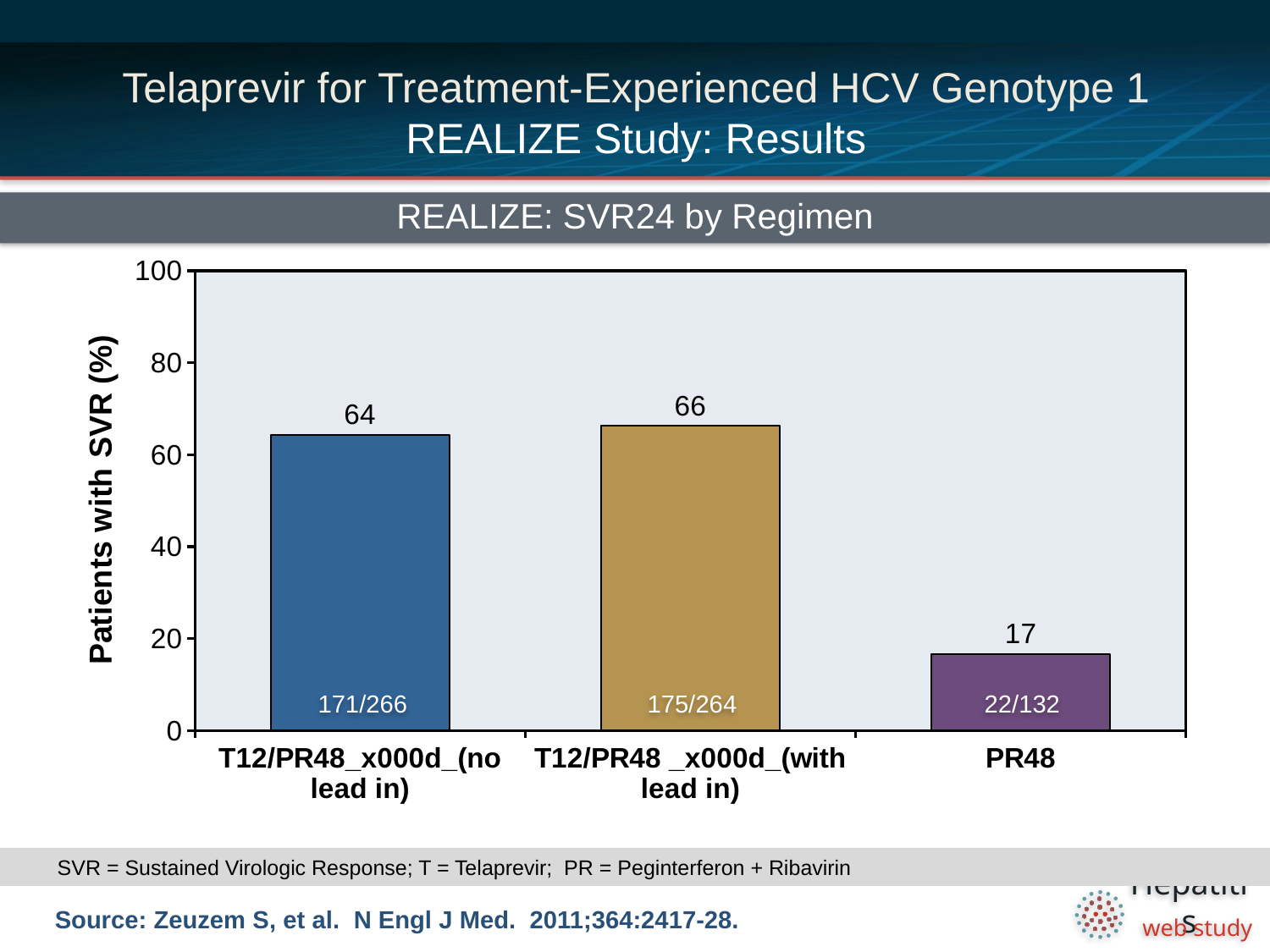
What is the SVR rate for T12/PR48 (with lead in)? 66 What kind of chart is shown on the slide? bar chart What is the SVR rate for the PR48 regimen? 17 What is the difference in SVR rate between T12/PR48 (with lead in) and T12/PR48 (no lead in)? 2 Which has a larger SVR rate, T12/PR48 (no lead in) or PR48? T12/PR48 (no lead in) What fraction of patients is printed inside the PR48 bar? 22/132 How many regimens are shown in the chart? 3 Which regimen has the lowest SVR rate? PR48 What is the difference in SVR rate between T12/PR48 (with lead in) and PR48? 49 Which regimen has the highest SVR rate? T12/PR48 (with lead in) What is the SVR rate for T12/PR48 (no lead in)? 64 Is the SVR rate for PR48 greater or less than 20? less